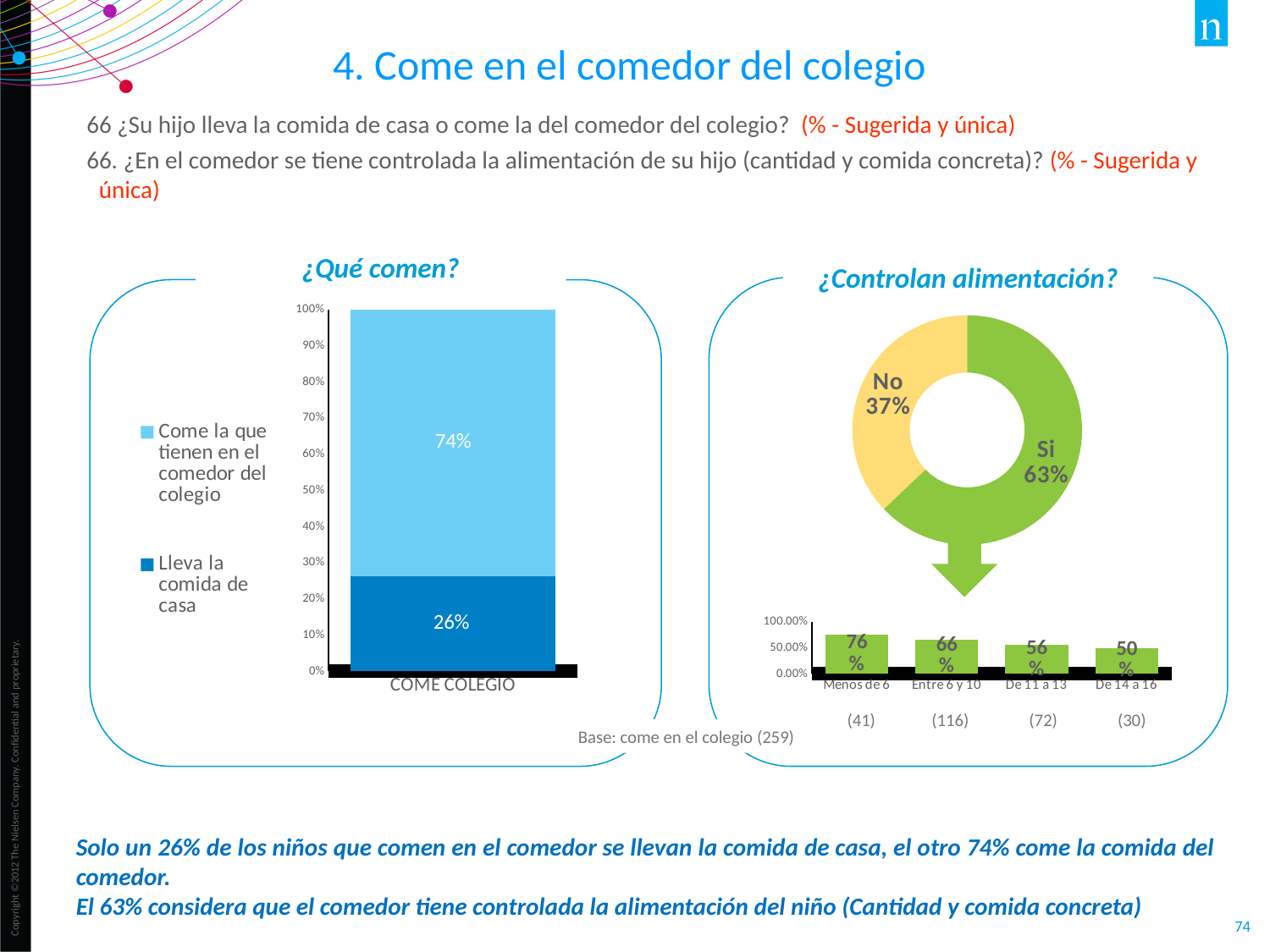
In the '¿Qué comen?' chart, what percentage is shown for 'Come la que tienen en el comedor del colegio'? 74% In the '¿Controlan alimentación?' donut chart, what share is labelled 'No'? 37% In the small bar chart by age group under the donut, what is the value for 'Menos de 6'? 76% In the small bar chart by age group under the donut, which age group has the lowest value? De 14 a 16 In the small bar chart by age group under the donut, do the values rise or fall from 'Menos de 6' to 'De 14 a 16'? Fall In the small bar chart by age group under the donut, how many age groups are shown? 4 In the '¿Controlan alimentación?' donut chart, what share is labelled 'Si'? 63% In the '¿Qué comen?' chart, how many series does the legend list? 2 In the '¿Controlan alimentación?' donut chart, which slice is larger, 'Si' or 'No'? Si What kind of chart is the '¿Qué comen?' chart? Stacked bar chart In the '¿Qué comen?' chart, what is the difference between the 'Come la que tienen en el comedor del colegio' value and the 'Lleva la comida de casa' value? 48% In the '¿Qué comen?' chart, what percentage is shown for 'Lleva la comida de casa'? 26%